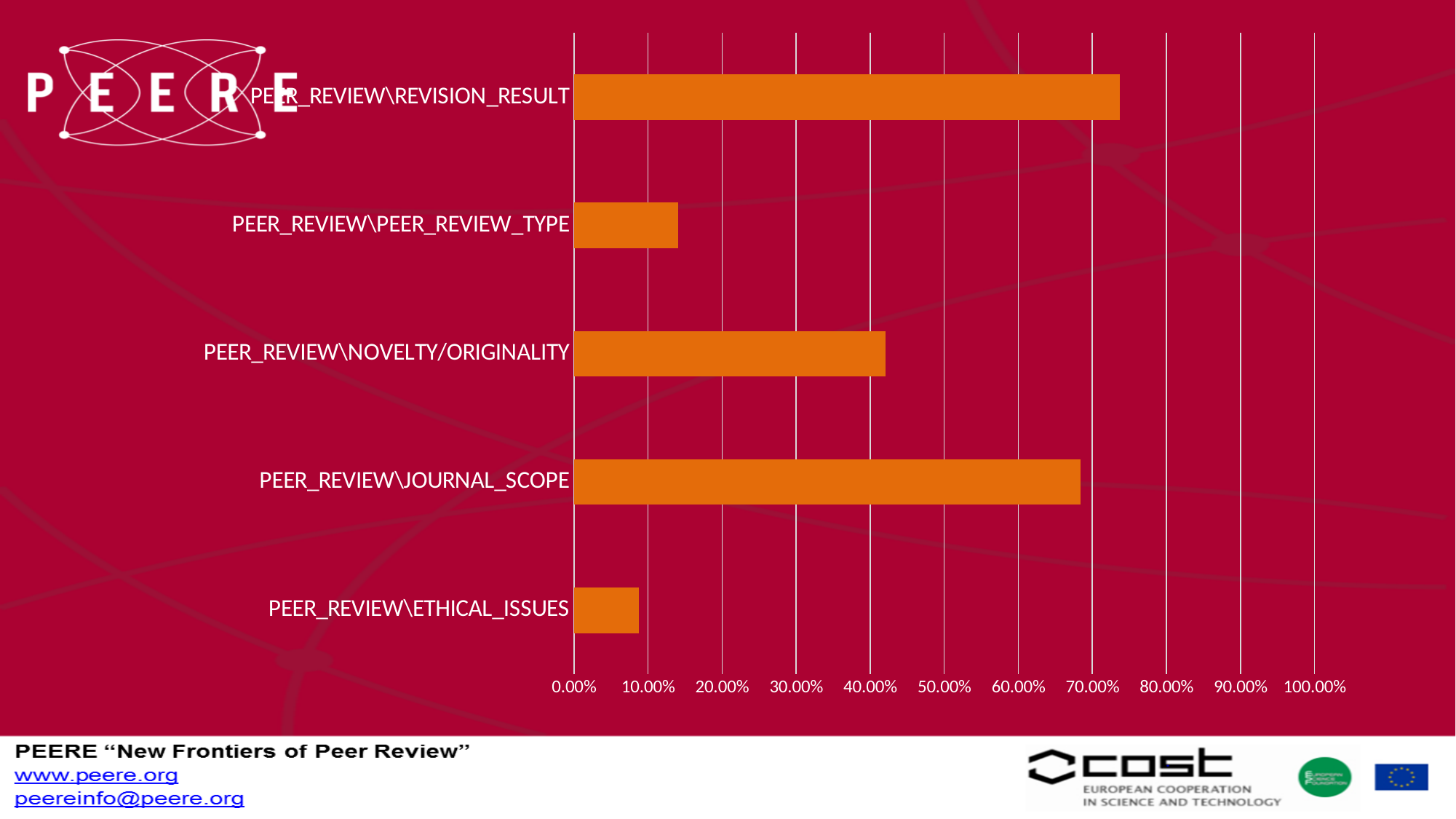
Is the value for PEER_REVIEW\NOVELTY/ORIGINALITY greater or less than 40.00%? greater Which is larger, the value for PEER_REVIEW\JOURNAL_SCOPE or the value for PEER_REVIEW\NOVELTY/ORIGINALITY? PEER_REVIEW\JOURNAL_SCOPE What kind of chart is shown on the slide? bar chart Is the value for PEER_REVIEW\JOURNAL_SCOPE greater or less than 70.00%? less Which category has the highest value in the bar chart? PEER_REVIEW\REVISION_RESULT How many categories are plotted in the bar chart? 5 Which category has the lowest value in the bar chart? PEER_REVIEW\ETHICAL_ISSUES Is the value for PEER_REVIEW\PEER_REVIEW_TYPE greater or less than 20.00%? less What is the maximum value shown on the horizontal axis of the chart? 100.00% Which is larger, the value for PEER_REVIEW\PEER_REVIEW_TYPE or the value for PEER_REVIEW\ETHICAL_ISSUES? PEER_REVIEW\PEER_REVIEW_TYPE